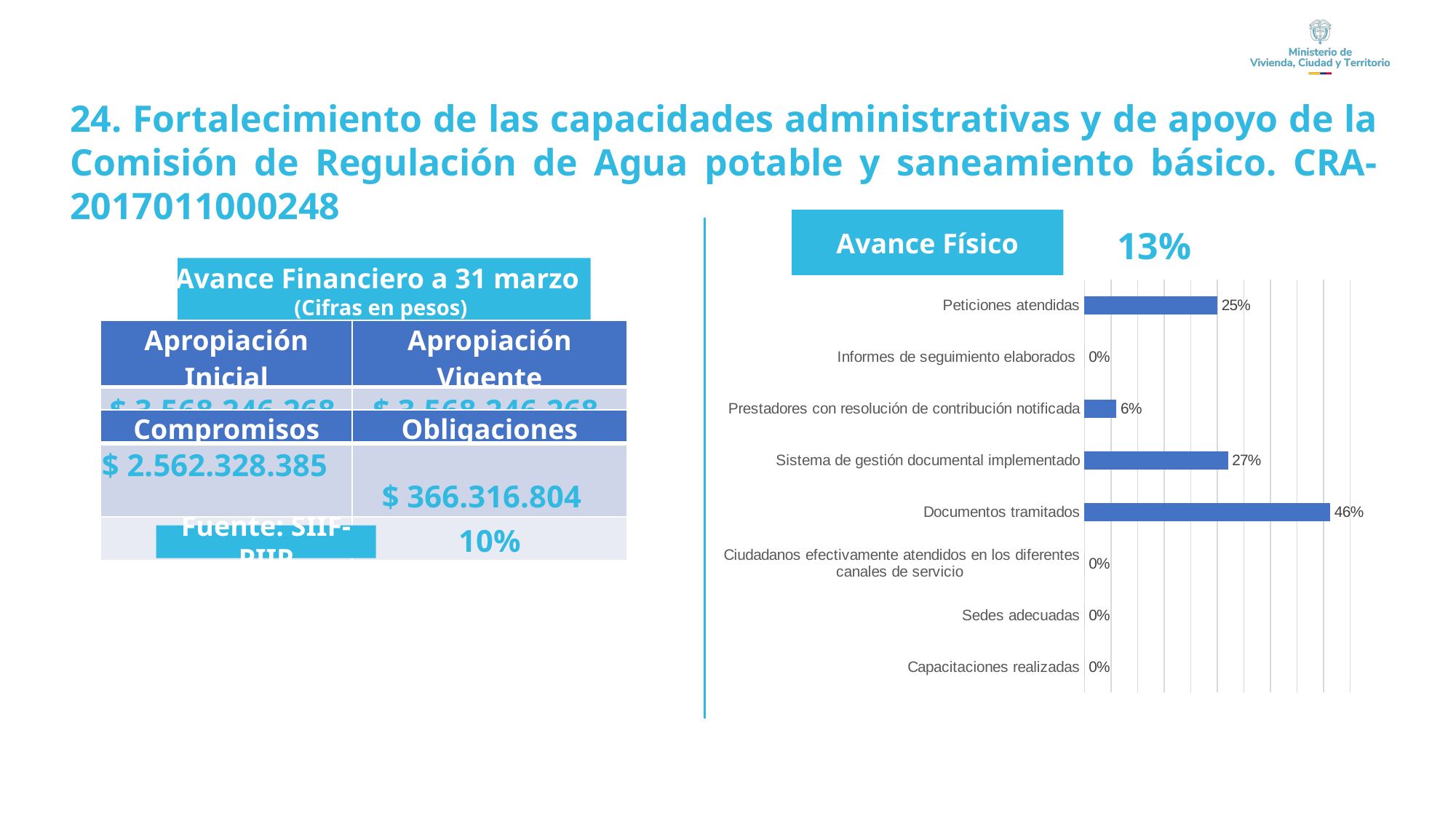
What type of chart is the Avance Físico chart? Bar chart What is the difference between Sistema de gestión documental implementado and Prestadores con resolución de contribución notificada in the Avance Físico chart? 21% What is the value for Prestadores con resolución de contribución notificada in the Avance Físico chart? 6% What is the value for Sedes adecuadas in the Avance Físico chart? 0% What is the difference between Documentos tramitados and Peticiones atendidas in the Avance Físico chart? 21% What is the value for Peticiones atendidas in the Avance Físico chart? 25% How many categories in the Avance Físico chart have a value of 0%? 4 What is the value for Sistema de gestión documental implementado in the Avance Físico chart? 27% Which category has the highest value in the Avance Físico chart? Documentos tramitados What is the value for Documentos tramitados in the Avance Físico chart? 46% Which is larger in the Avance Físico chart: Sistema de gestión documental implementado or Peticiones atendidas? Sistema de gestión documental implementado How many categories are shown in the Avance Físico chart? 8